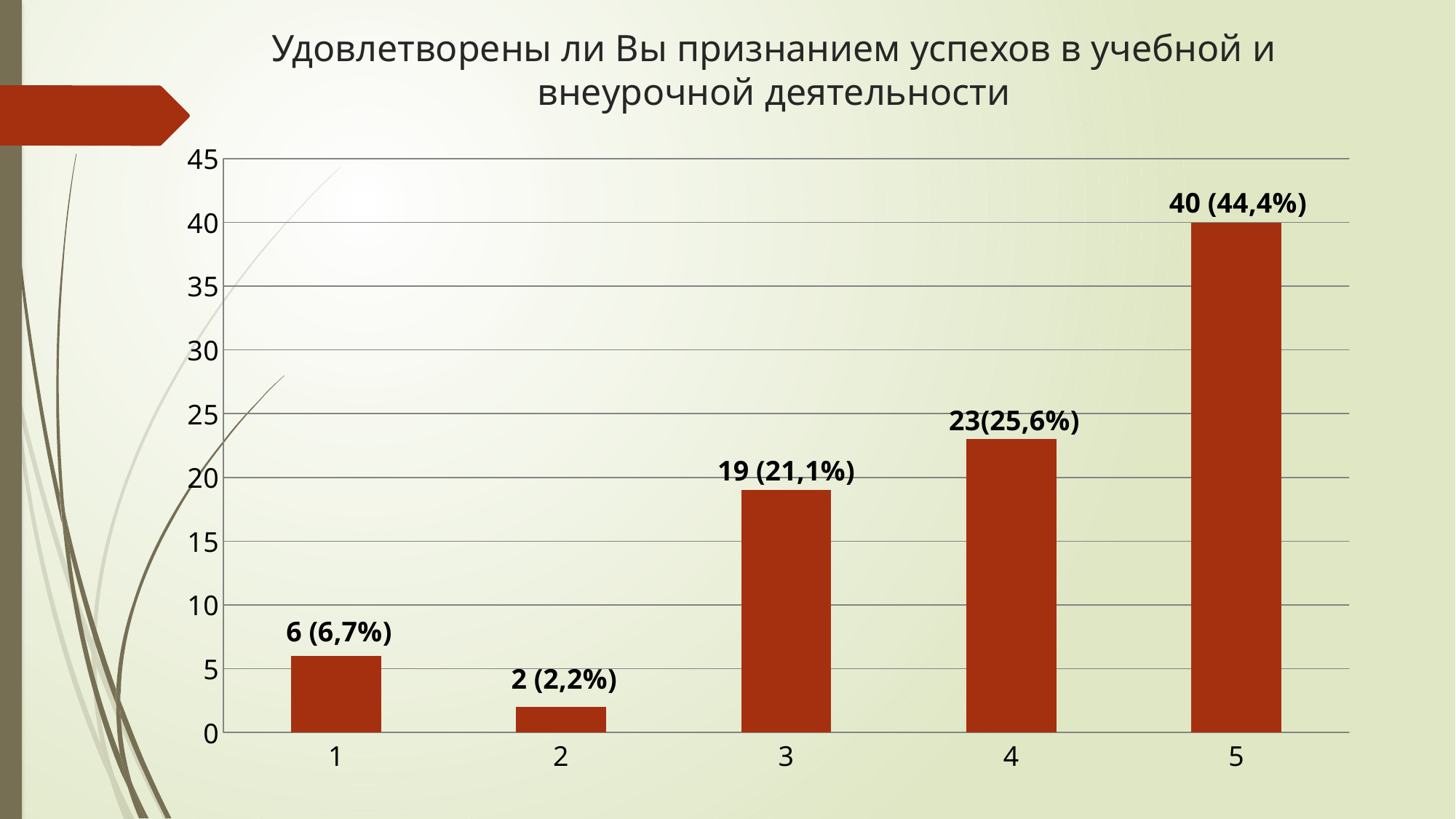
What is the difference between the count for category 3 and the count for category 1? 13 What is the total of the counts across all five categories? 90 What is the data label shown on the bar for category 3? 19 (21,1%) Is the value for category 4 greater or less than 20? greater What kind of chart is shown on the slide? bar chart Which is larger, the value for category 1 or the value for category 2? category 1 Which category has the lowest bar? 2 Which category has the highest bar? 5 What is the data label shown on the bar for category 5? 40 (44,4%) What is the data label shown on the bar for category 2? 2 (2,2%) What is the difference between the count for category 5 and the count for category 4? 17 How many categories are shown on the x axis? 5